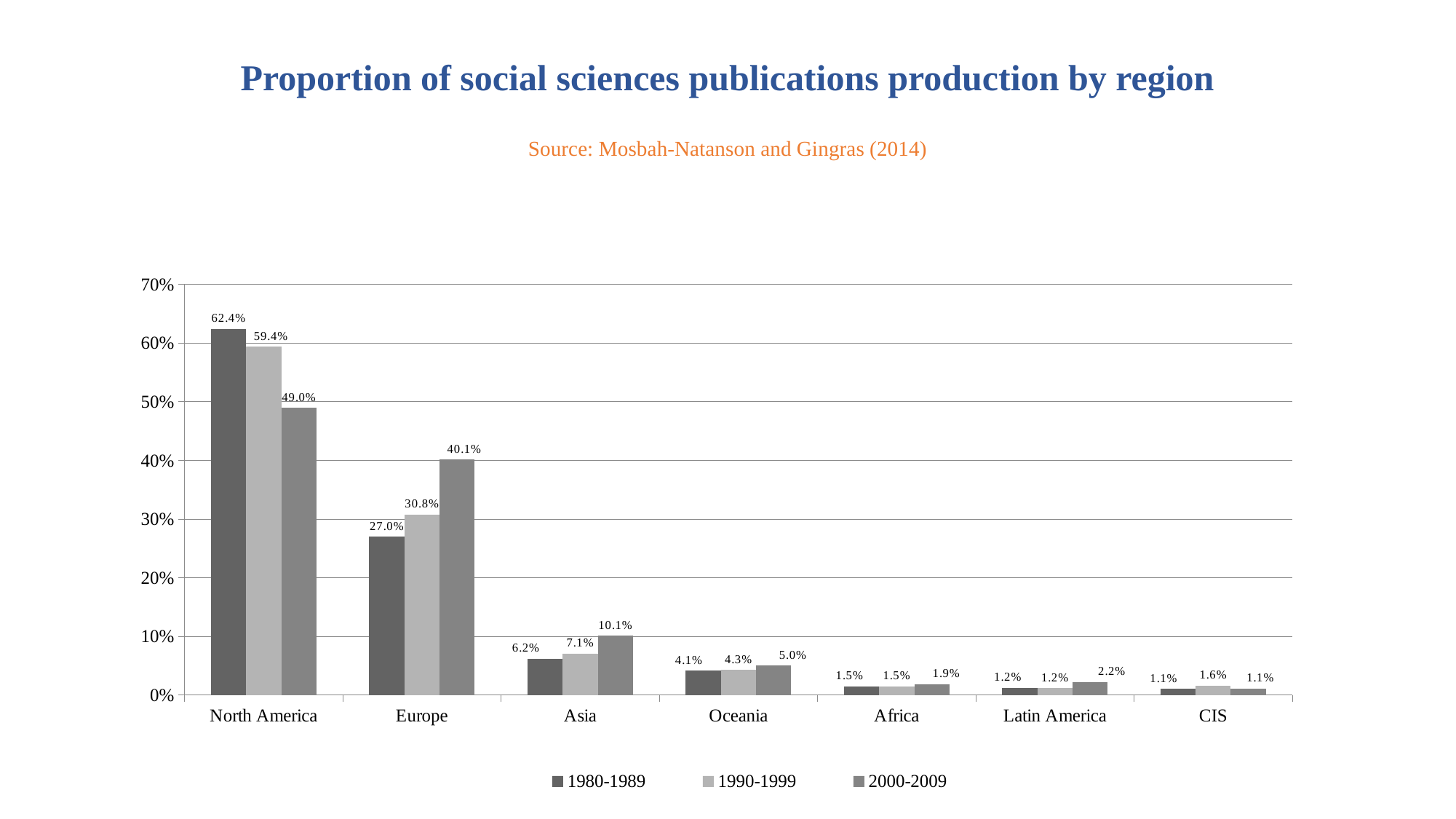
How many regions are shown on the x axis? 7 What kind of chart is shown on the slide? bar chart Which is larger for Europe: the 1980-1989 value or the 2000-2009 value? 2000-2009 What is the value for North America in the 1980-1989 series? 62.4% Do the values for Europe rise or fall from 1980-1989 to 2000-2009? rise Which region has the highest value in the 2000-2009 series? North America What is the value for Europe in the 2000-2009 series? 40.1% What is the difference between the 1980-1989 and 2000-2009 values for North America? 13.4% What is the value for Asia in the 1990-1999 series? 7.1% Is the 1990-1999 value for North America greater or less than 50%? greater How many series does the legend list? 3 Which region has the lowest value in the 1980-1989 series? CIS